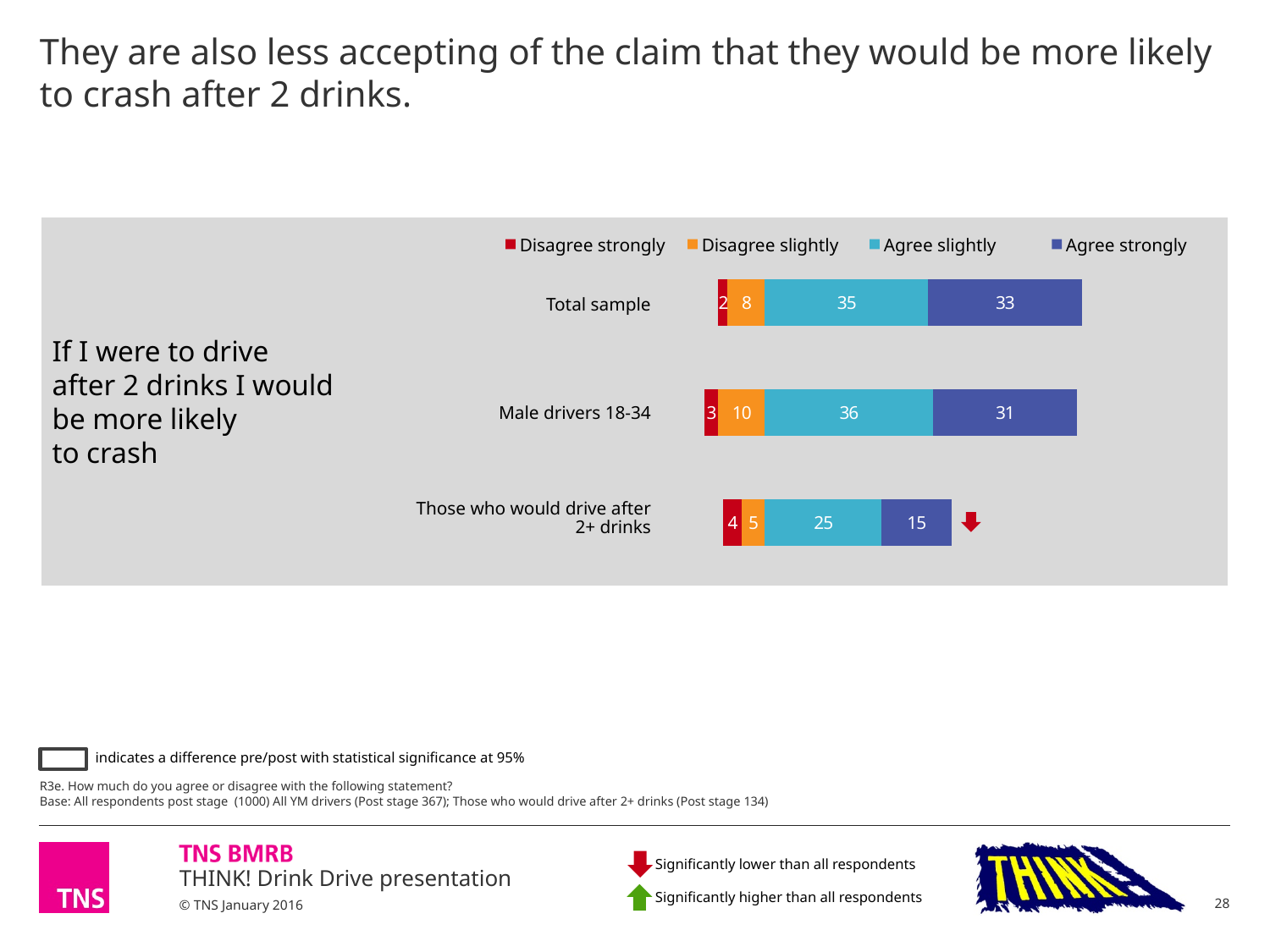
How many series does the legend list? 4 What kind of chart is shown on the slide? Stacked bar chart Which category has the lowest 'Agree slightly' value? Those who would drive after 2+ drinks What is the 'Disagree strongly' value for Male drivers 18-34? 3 How many categories are shown in the chart? 3 What is the 'Agree slightly' value for Male drivers 18-34? 36 What is the 'Disagree slightly' value for Those who would drive after 2+ drinks? 5 What is the 'Agree strongly' value for Total sample? 33 Which category has the highest 'Agree strongly' value? Total sample Which is larger: the 'Disagree slightly' value for Male drivers 18-34 or for Total sample? Male drivers 18-34 What is the total of the stacked bar for Those who would drive after 2+ drinks? 49 What is the difference between the 'Agree strongly' values for Total sample and Those who would drive after 2+ drinks? 18